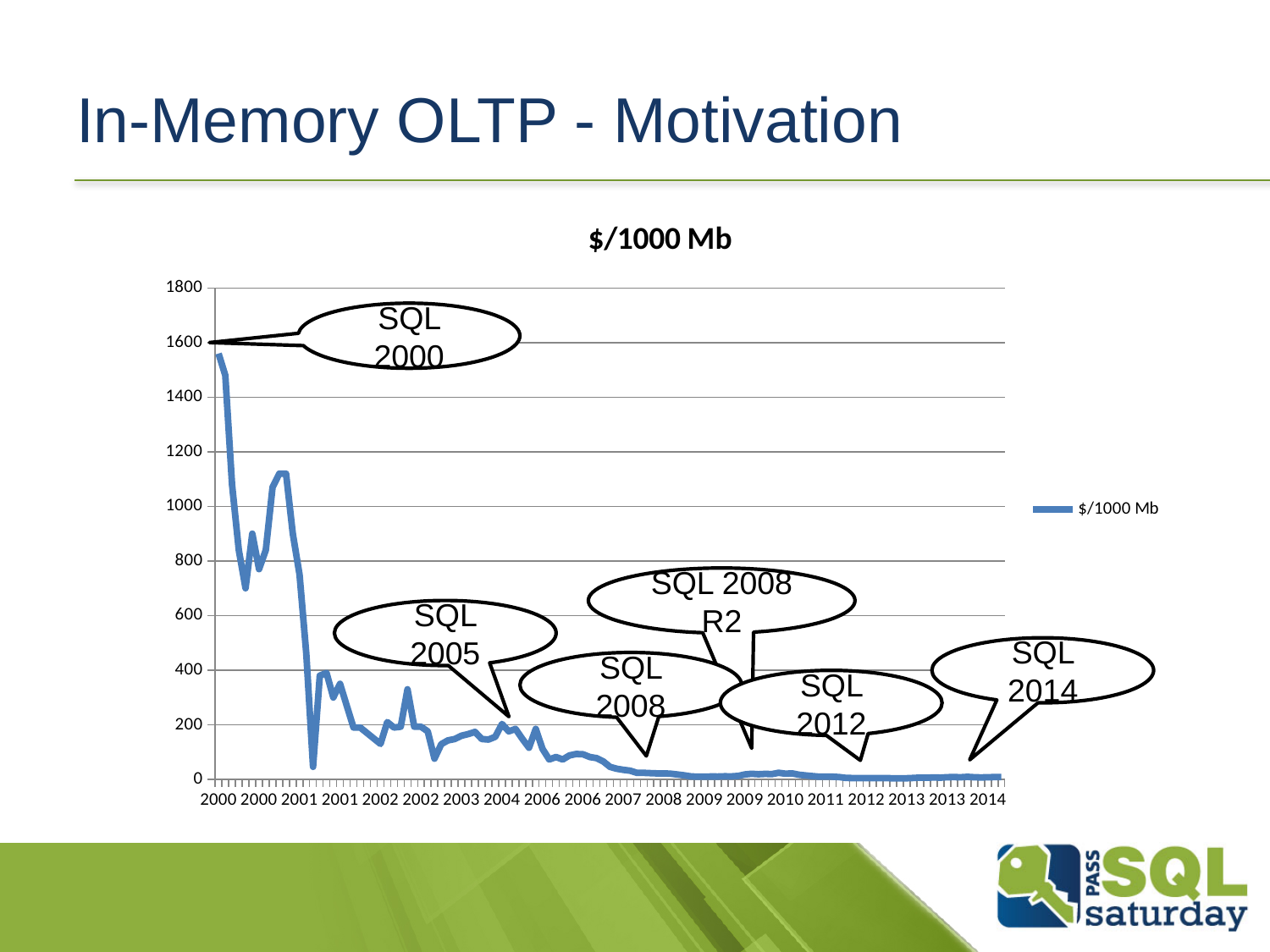
Which is larger, the $/1000 Mb value in 2000 or in 2014? 2000 How many series does the legend list? 1 What is the title of the chart? $/1000 Mb Is the $/1000 Mb value in 2014 greater or less than 200? less Is the $/1000 Mb value in 2007 greater or less than 400? less Which is larger, the $/1000 Mb value in 2003 or in 2011? 2003 What kind of chart is shown on the slide? line chart Do the values generally rise or fall along the x axis from 2000 to 2014? fall How many SQL Server version callouts are placed on the chart? 6 Which year has the highest $/1000 Mb value? 2000 Is the $/1000 Mb value at the start of 2000 greater or less than 1400? greater